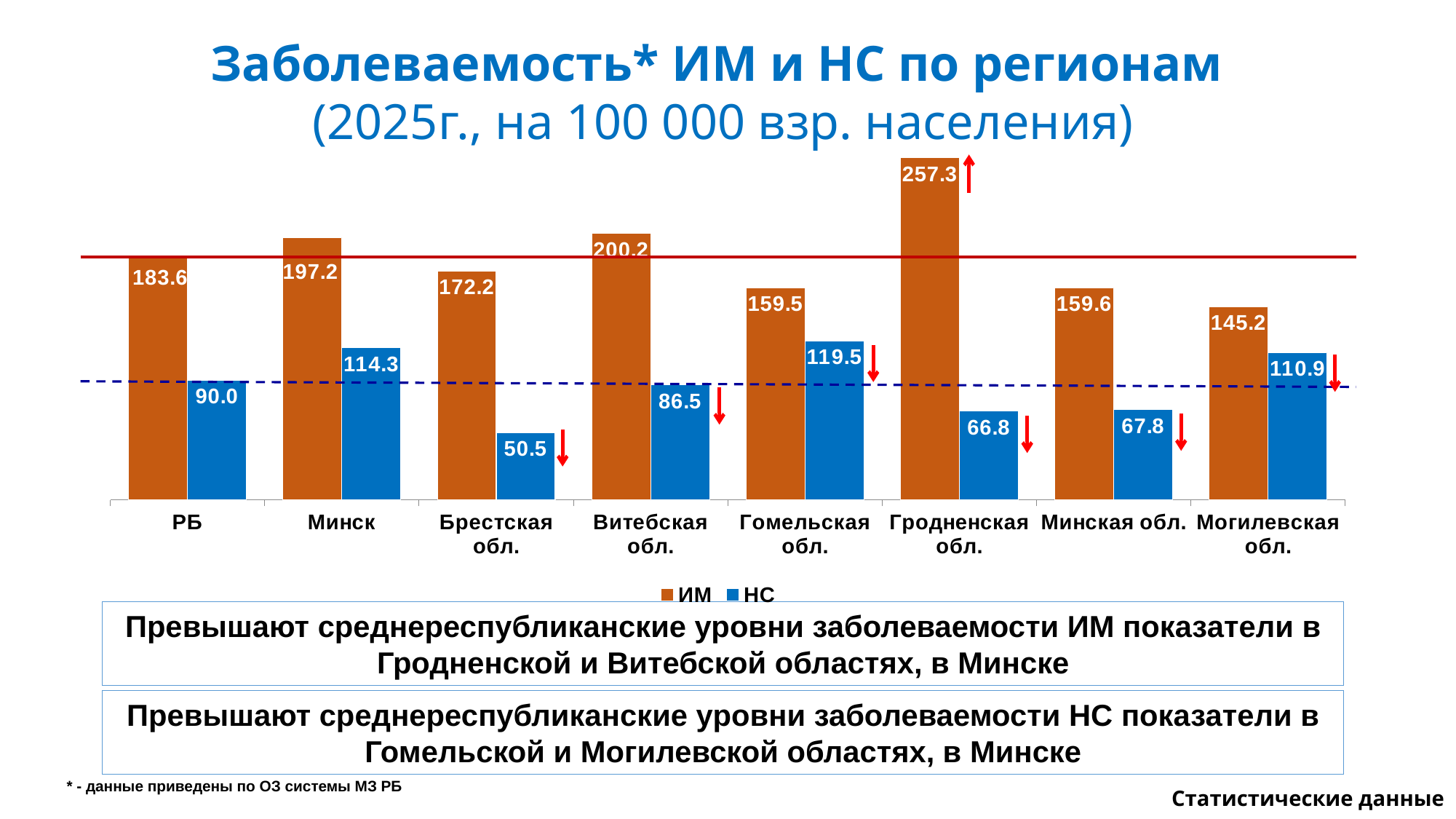
Which is larger: the НС value for Могилевская обл. or the НС value for Витебская обл.? Могилевская обл. What is the ИМ value for Гродненская обл.? 257.3 What is the difference between the ИМ value for Гродненская обл. and the ИМ value for РБ? 73.7 What kind of chart is shown on the slide? Bar chart How many categories are shown on the x axis? 8 Which region has the lowest НС value? Брестская обл. What is the ИМ value for РБ? 183.6 What is the НС value for Минск? 114.3 Which region has the highest ИМ value? Гродненская обл. How many series does the legend list? 2 Which region has the highest НС value? Гомельская обл. What is the НС value for Брестская обл.? 50.5